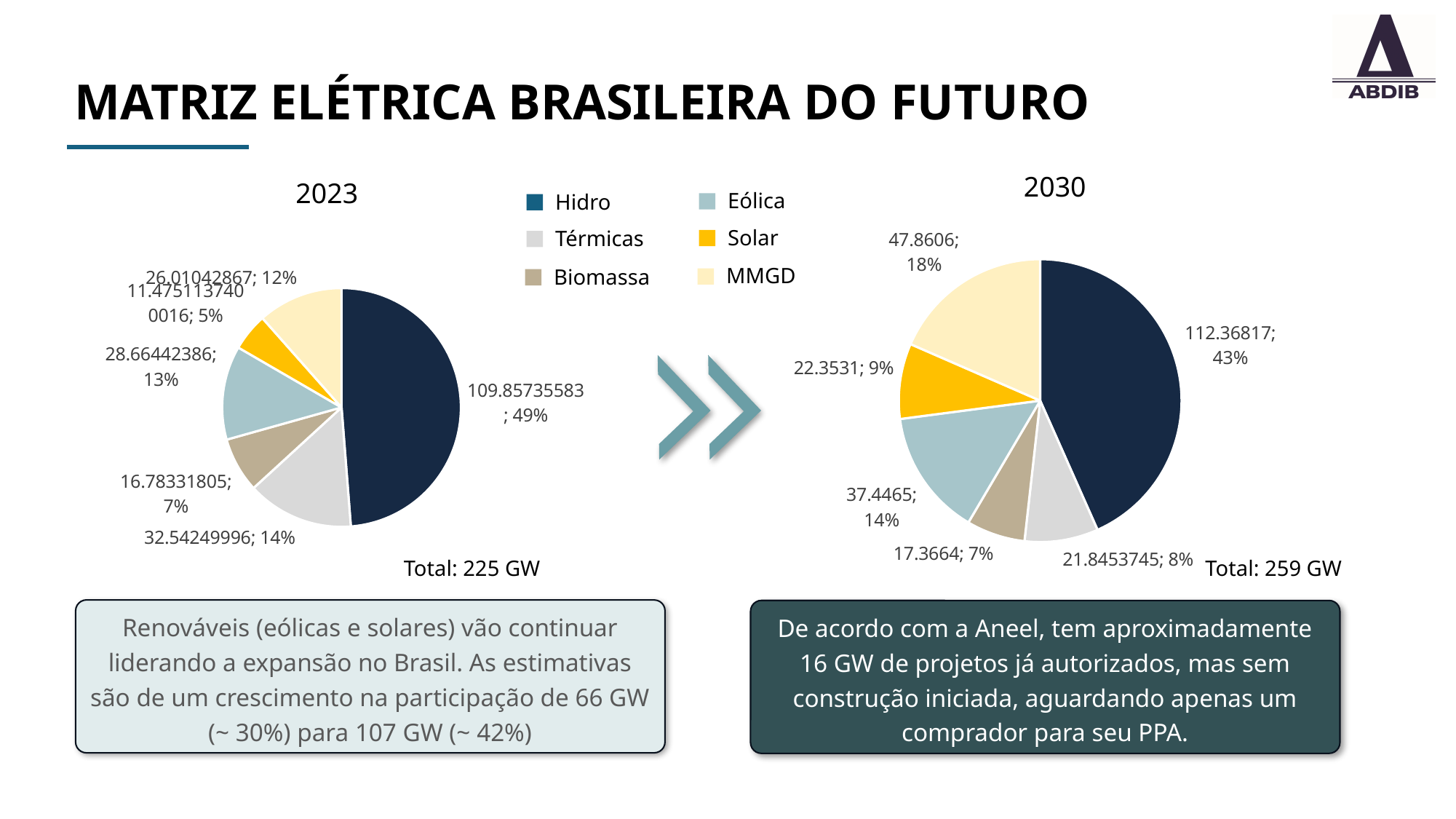
How many categories does the legend list for the pie charts? 6 What total is shown below the 2030 pie chart? Total: 259 GW In the 2023 pie chart, what share does Eólica have? 13% What type of chart is used for the 2023 and 2030 data on this slide? Pie chart In the 2023 pie chart, what is the value shown for Térmicas? 32.54249996 In the 2030 pie chart, what is the value shown for Eólica? 37.4465 In the 2023 pie chart, which category has the smallest slice? Solar In the 2030 pie chart, which category has the largest slice? Hidro In the 2030 pie chart, what share does MMGD have? 18% What is the title of the slide containing the two pie charts? MATRIZ ELÉTRICA BRASILEIRA DO FUTURO In the 2030 pie chart, which is larger, the Solar slice or the Térmicas slice? Solar In the 2023 pie chart, what share does Hidro have? 49%